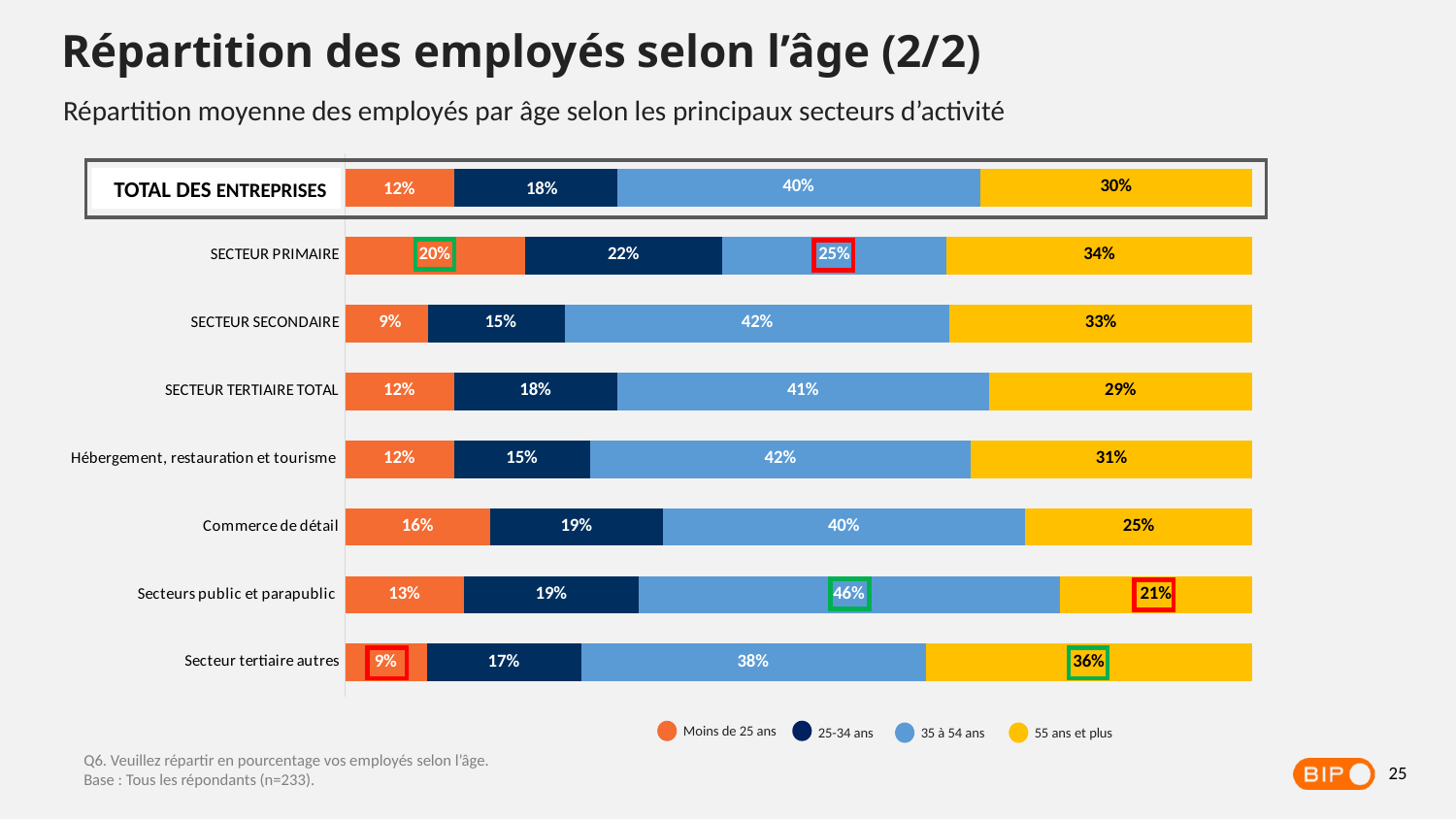
Which age group is represented by the yellow segments in the chart? 55 ans et plus How many series does the legend list? 4 What is the difference between the '55 ans et plus' share for Secteur tertiaire autres and for Secteurs public et parapublic? 15% What kind of chart is shown on the slide? Stacked bar chart Which sector has the lowest share of '55 ans et plus' employees? Secteurs public et parapublic What is the '55 ans et plus' value for TOTAL DES ENTREPRISES? 30% What is the total of the stacked bar for Commerce de détail? 100% What is the '35 à 54 ans' share for Secteurs public et parapublic? 46% Which sector has the highest share of 'Moins de 25 ans' employees? SECTEUR PRIMAIRE How many bars (sector rows) are shown in the chart? 8 What percentage of employees in SECTEUR PRIMAIRE are 'Moins de 25 ans'? 20% Which is larger: the '25-34 ans' share for SECTEUR PRIMAIRE or for SECTEUR SECONDAIRE? SECTEUR PRIMAIRE